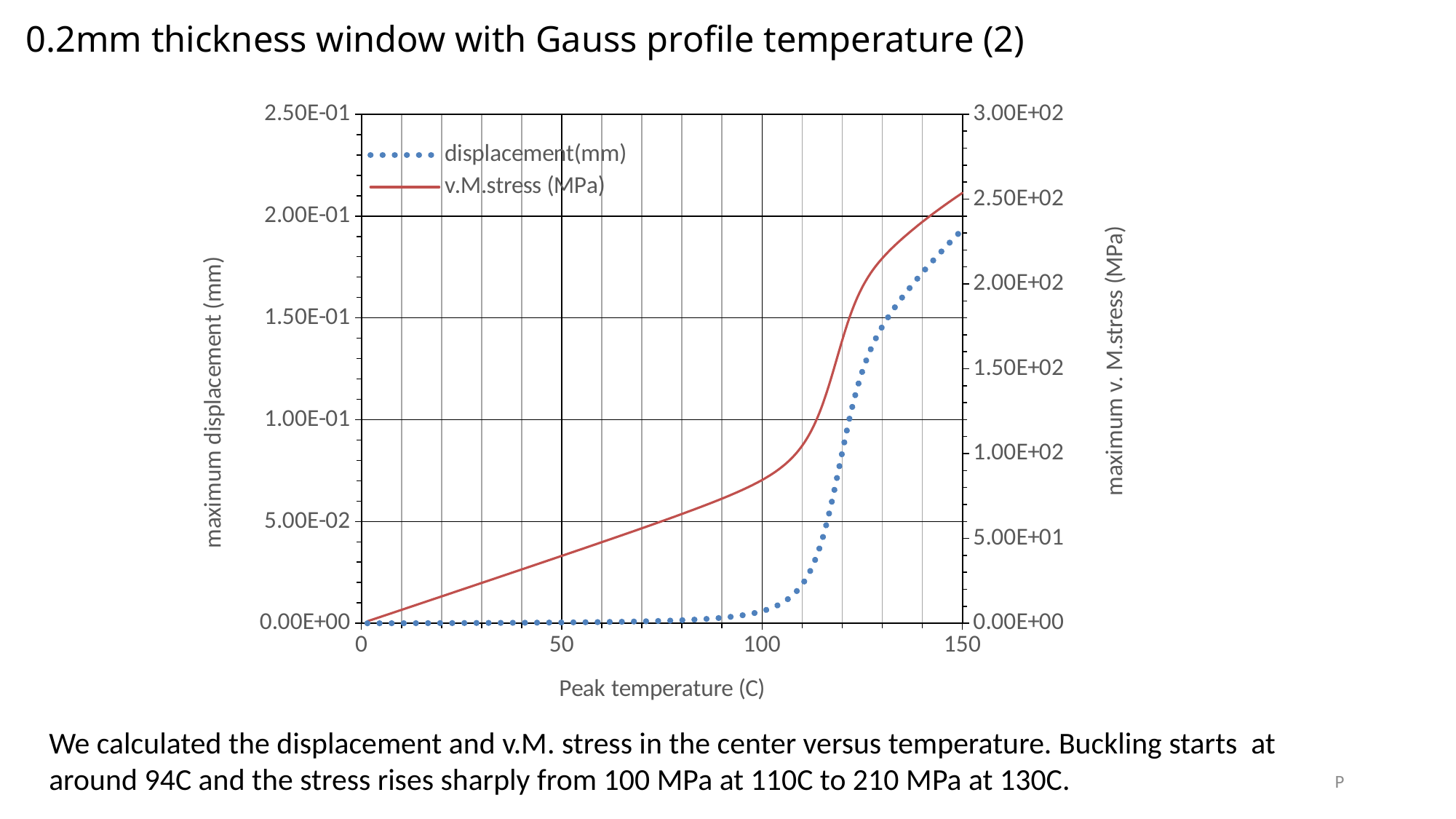
Does the v.M.stress (MPa) series rise or fall as peak temperature increases? rise Is the displacement value at a peak temperature of 150 C greater or less than 1.50E-01 mm? greater Is the displacement value at a peak temperature of 100 C greater or less than 5.00E-02 mm? less Is the v.M.stress value at a peak temperature of 100 C greater or less than 1.00E+02 MPa? less Which two series are listed in the chart legend? displacement(mm) and v.M.stress (MPa) What kind of chart is shown on the slide? line chart How many series does the chart legend list? 2 Does the displacement(mm) series rise or fall as peak temperature increases from 100 to 150? rise What is the title of the x axis of the chart? Peak temperature (C)